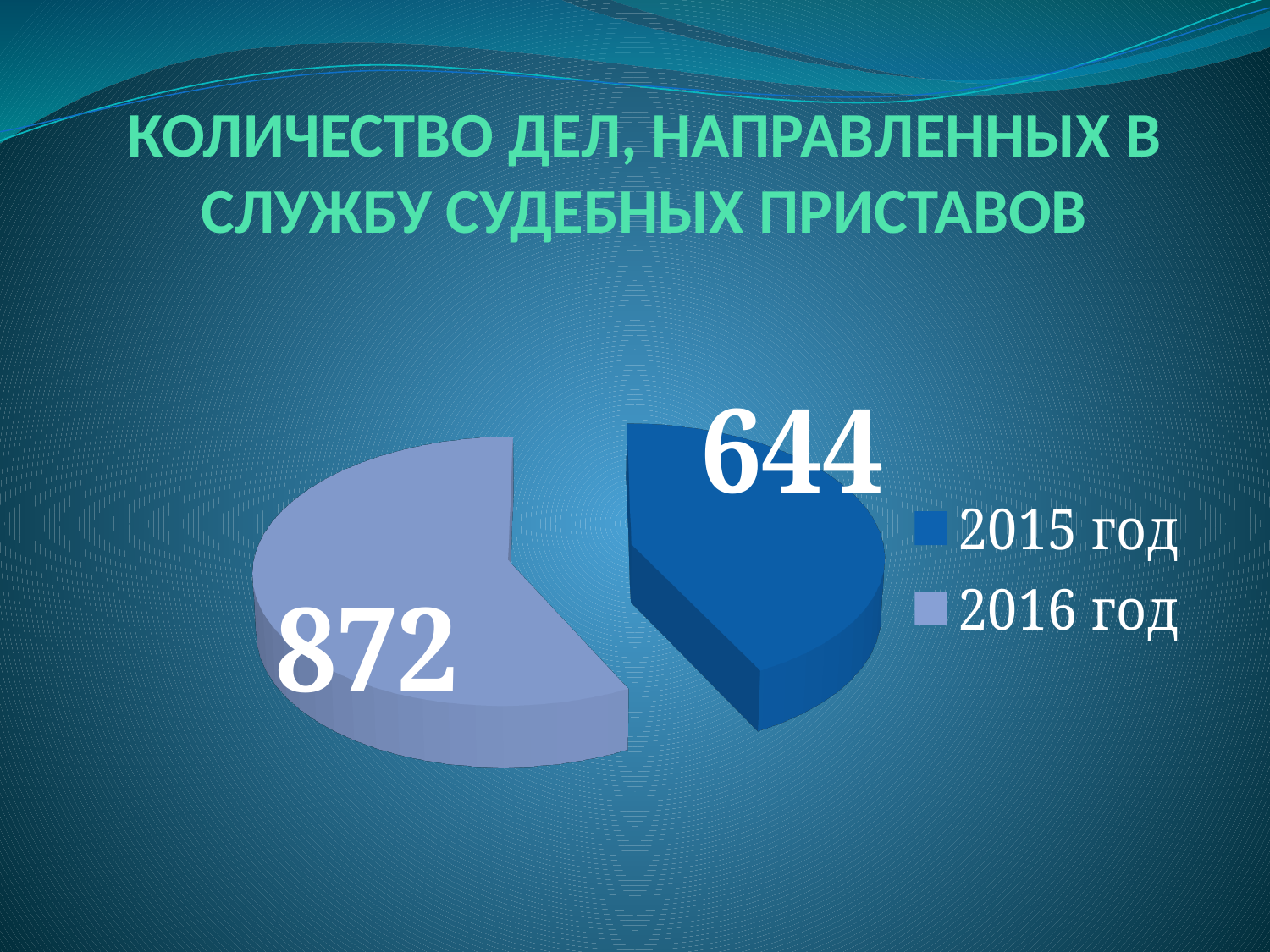
Which year has the smaller slice of the pie? 2015 год What type of chart is shown on the slide? pie chart Which year has the larger slice of the pie? 2016 год Which legend entry is shown in dark blue? 2015 год How many slices does the pie chart have? 2 How many entries does the legend list? 2 What is the total of the two values shown in the pie chart? 1516 What is the title of the chart? КОЛИЧЕСТВО ДЕЛ, НАПРАВЛЕННЫХ В СЛУЖБУ СУДЕБНЫХ ПРИСТАВОВ What is the difference between the values for 2016 год and 2015 год? 228 What is the value for 2015 год? 644 What is the value for 2016 год? 872 Is the value for 2016 год larger or smaller than the value for 2015 год? larger